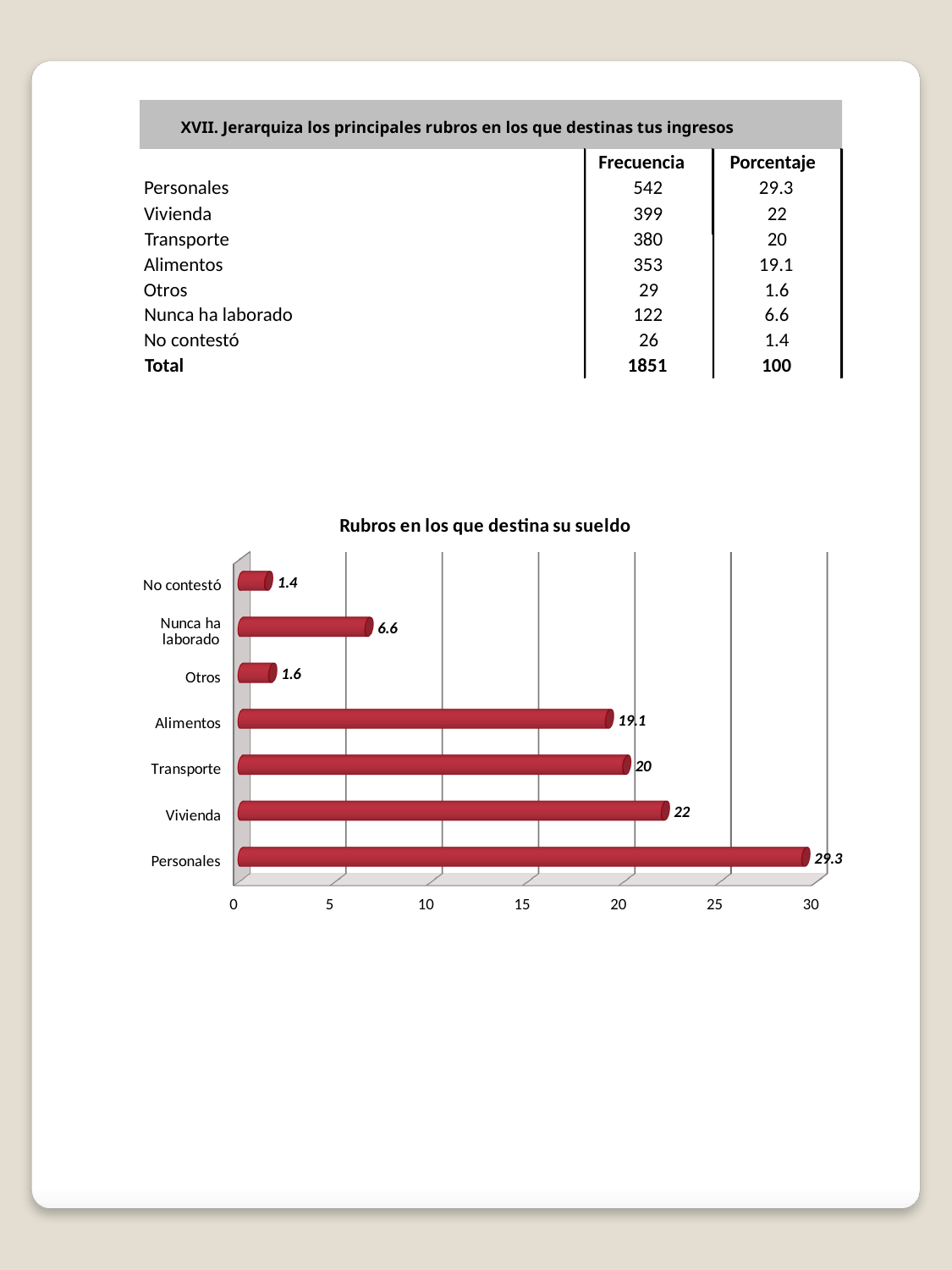
Which category has the highest value in the chart? Personales What is the difference between the values for Vivienda and Transporte? 2 Which category has the lowest value in the chart? No contestó Which is larger, the value for Otros or the value for Nunca ha laborado? Nunca ha laborado How many categories are shown in the chart? 7 What is the value for Personales in the chart? 29.3 What is the value for Nunca ha laborado in the chart? 6.6 What is the value for Alimentos in the chart? 19.1 What is the title of the chart? Rubros en los que destina su sueldo What kind of chart is shown on the slide? bar chart Is the value for Vivienda greater or less than 20? greater What is the difference between the values for Personales and Alimentos? 10.2